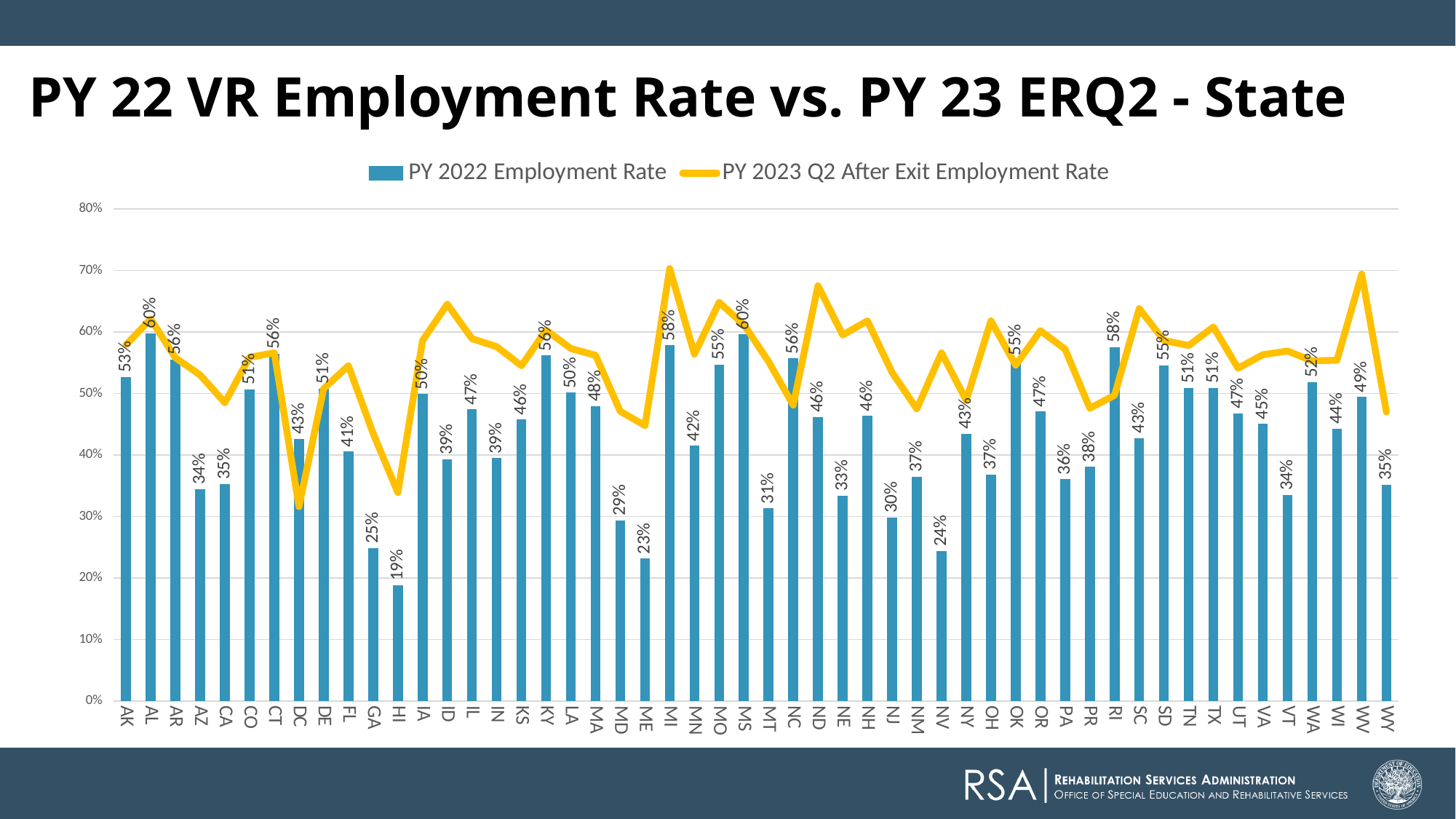
What is the PY 2022 Employment Rate for HI? 19% What is the PY 2022 Employment Rate for MI? 58% Is the PY 2022 Employment Rate for ME greater or less than 30%? less What kind of chart is shown on the slide? Combination bar and line chart What is the difference between the PY 2022 Employment Rate for MI and for MN? 16 percentage points How many states/territories are shown on the x axis? 52 Which state has the lowest PY 2022 Employment Rate? HI Is the PY 2023 Q2 After Exit Employment Rate for DC greater or less than 40%? less How many series does the legend list? 2 What is the PY 2022 Employment Rate for NV? 24% Which has a higher PY 2022 Employment Rate, GA or HI? GA What is the difference between the PY 2022 Employment Rate for AL and for HI? 41 percentage points